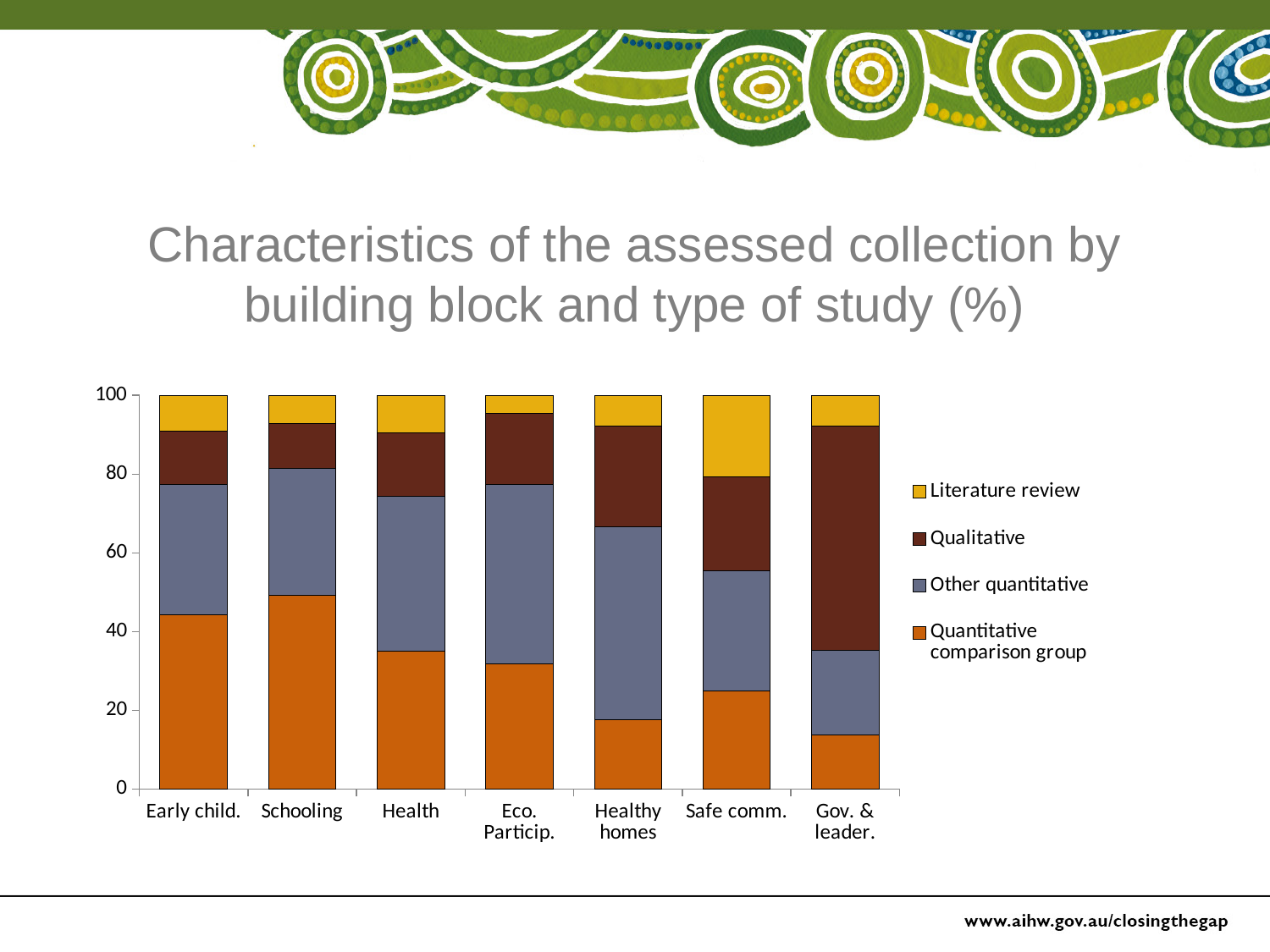
Which building block has the largest Qualitative share? Gov. & leader. Which series is listed first (at the top) in the legend? Literature review What kind of chart is shown on the slide? Stacked bar chart Is the Quantitative comparison group value for Health greater or less than 40? less Which building block has the largest Quantitative comparison group share? Schooling How many series does the legend list? 4 Which building block has the largest Literature review share? Safe comm. Which has the larger Quantitative comparison group share, Health or Safe comm.? Health Is the Quantitative comparison group value for Healthy homes greater or less than 20? less How many building blocks (categories) are shown on the x axis? 7 Is the Quantitative comparison group value for Schooling greater or less than 40? greater What is the total of the stacked bar for Safe comm.? 100